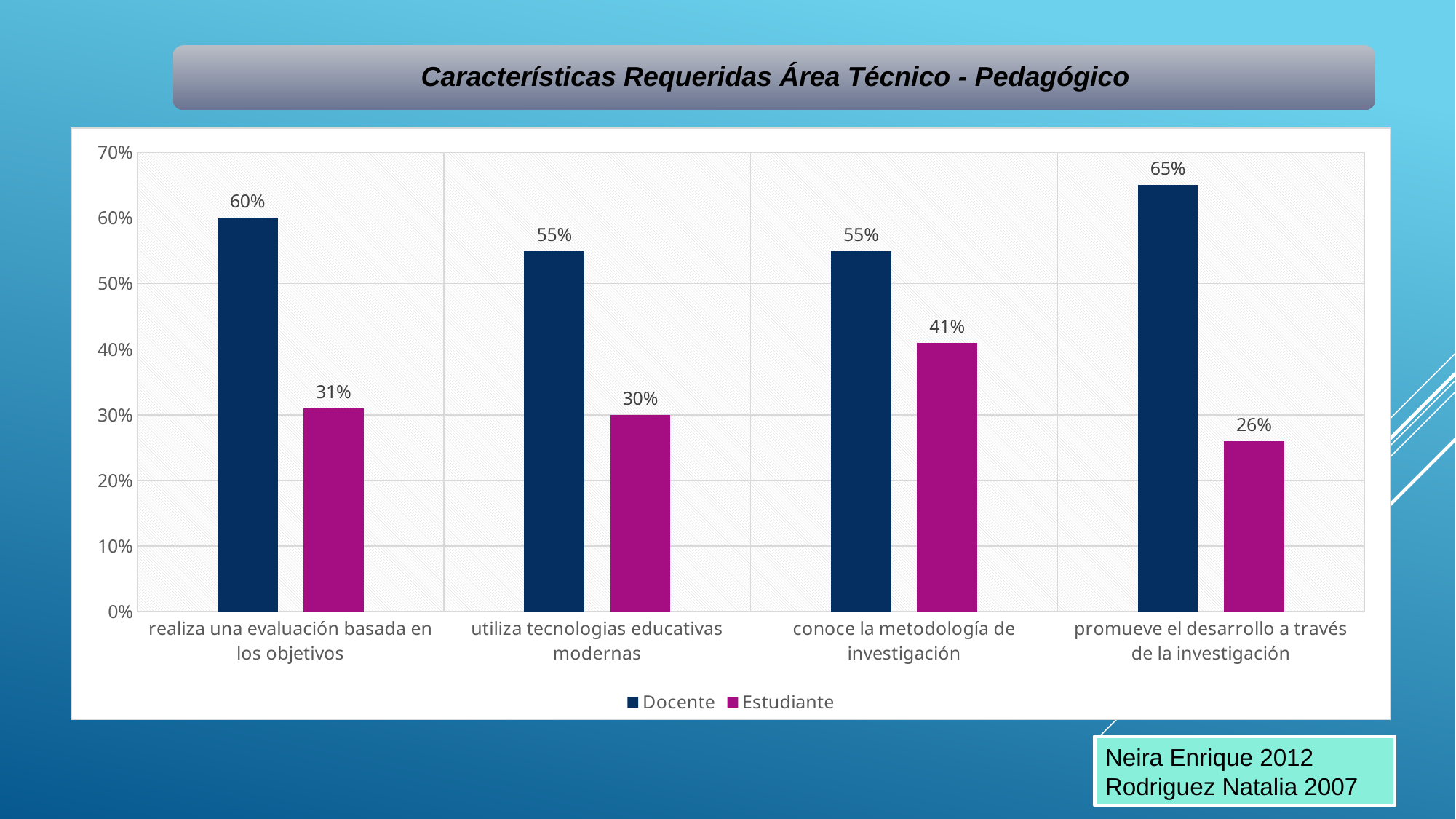
Which category has the highest Docente value? promueve el desarrollo a través de la investigación What kind of chart is shown on the slide? bar chart How many series does the legend list? 2 Is the Estudiante value for "realiza una evaluación basada en los objetivos" greater or less than 40%? less What is the difference between the Docente and Estudiante values for "utiliza tecnologias educativas modernas"? 25% What is the Estudiante value for "conoce la metodología de investigación"? 41% What is the Estudiante value for "promueve el desarrollo a través de la investigación"? 26% What is the title of the chart? Características Requeridas Área Técnico - Pedagógico What is the Docente value for "realiza una evaluación basada en los objetivos"? 60% How many categories are shown on the x axis? 4 Which category has the lowest Estudiante value? promueve el desarrollo a través de la investigación Which is larger for "conoce la metodología de investigación": the Docente value or the Estudiante value? Docente